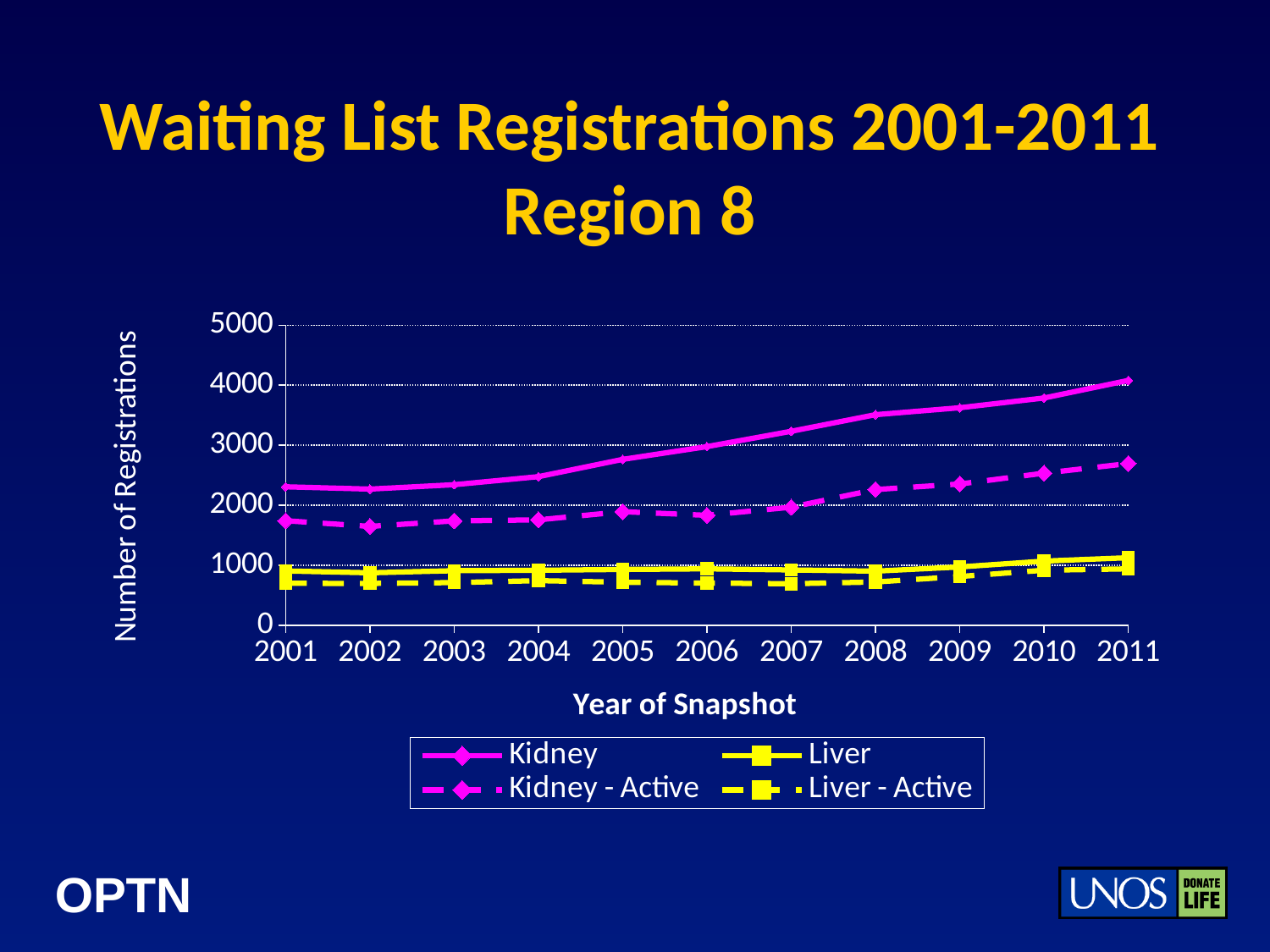
What is the label of the y axis? Number of Registrations Is the Kidney - Active value for 2011 greater or less than 3000? less Does the Kidney series rise or fall from 2001 to 2011? Rise Is the Kidney value for 2007 greater or less than 3000? greater What is the label of the x axis? Year of Snapshot Is the Liver value for 2001 greater or less than 1000? less Which series has the highest value in 2011? Kidney How many series does the legend list? 4 Which series has the lowest value in 2001? Liver - Active In 2011, which is larger: the Kidney value or the Liver value? Kidney What kind of chart is shown on the slide? Line chart How many years are plotted along the x axis? 11